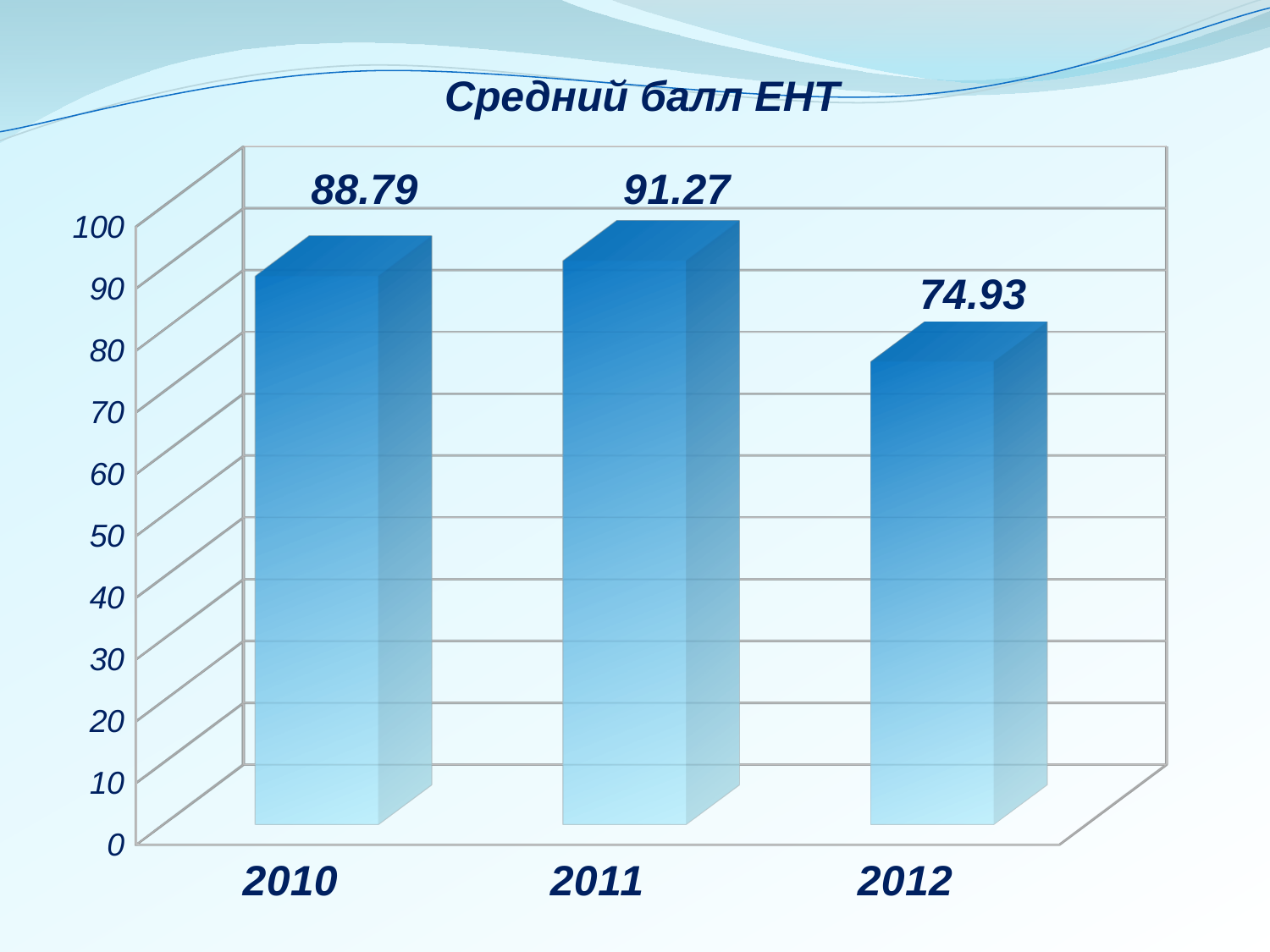
What kind of chart is shown on the slide? bar chart Which year has the lowest value? 2012 What is the value for 2010? 88.79 What is the difference between the values for 2011 and 2010? 2.48 Is the value for 2012 greater or less than 80? less What is the value for 2011? 91.27 What is the difference between the values for 2011 and 2012? 16.34 Which is larger, the value for 2010 or the value for 2012? 2010 How many years are shown on the chart? 3 What is the value for 2012? 74.93 What is the title of the chart? Средний балл ЕНТ Which year has the highest value? 2011